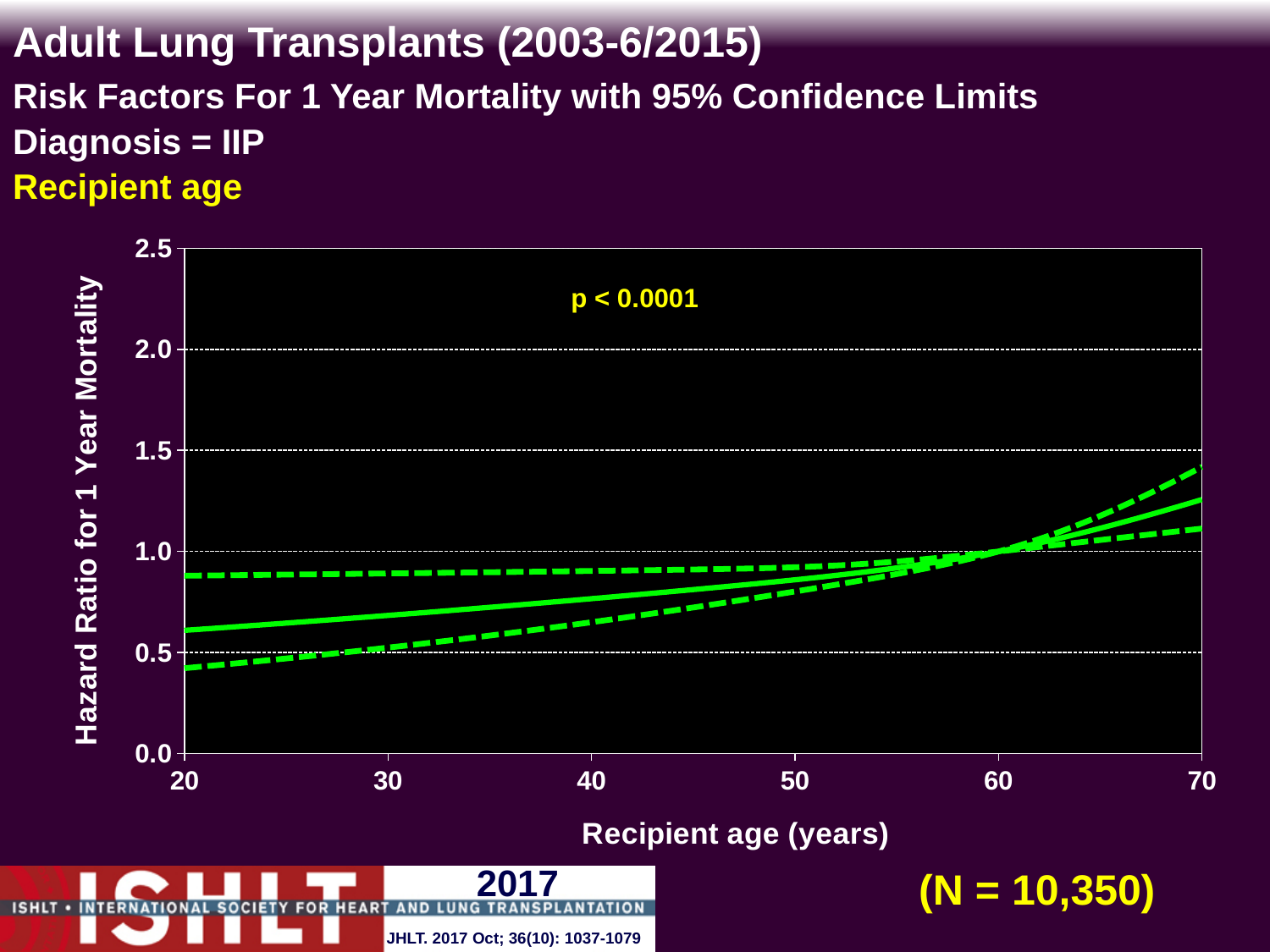
Is the lower 95% confidence limit (lower dashed line) at recipient age 20 greater or less than 0.5? less How many lines are plotted on the chart? 3 What p-value is printed on the chart? p < 0.0001 Is the upper 95% confidence limit (upper dashed line) at recipient age 70 greater or less than 1.5? less Is the upper 95% confidence limit (upper dashed line) at recipient age 20 greater or less than 1.0? less Does the hazard ratio for 1 year mortality rise or fall as recipient age increases from 20 to 70 years? rise What is the label of the x axis? Recipient age (years) What kind of chart is shown on the slide? line chart